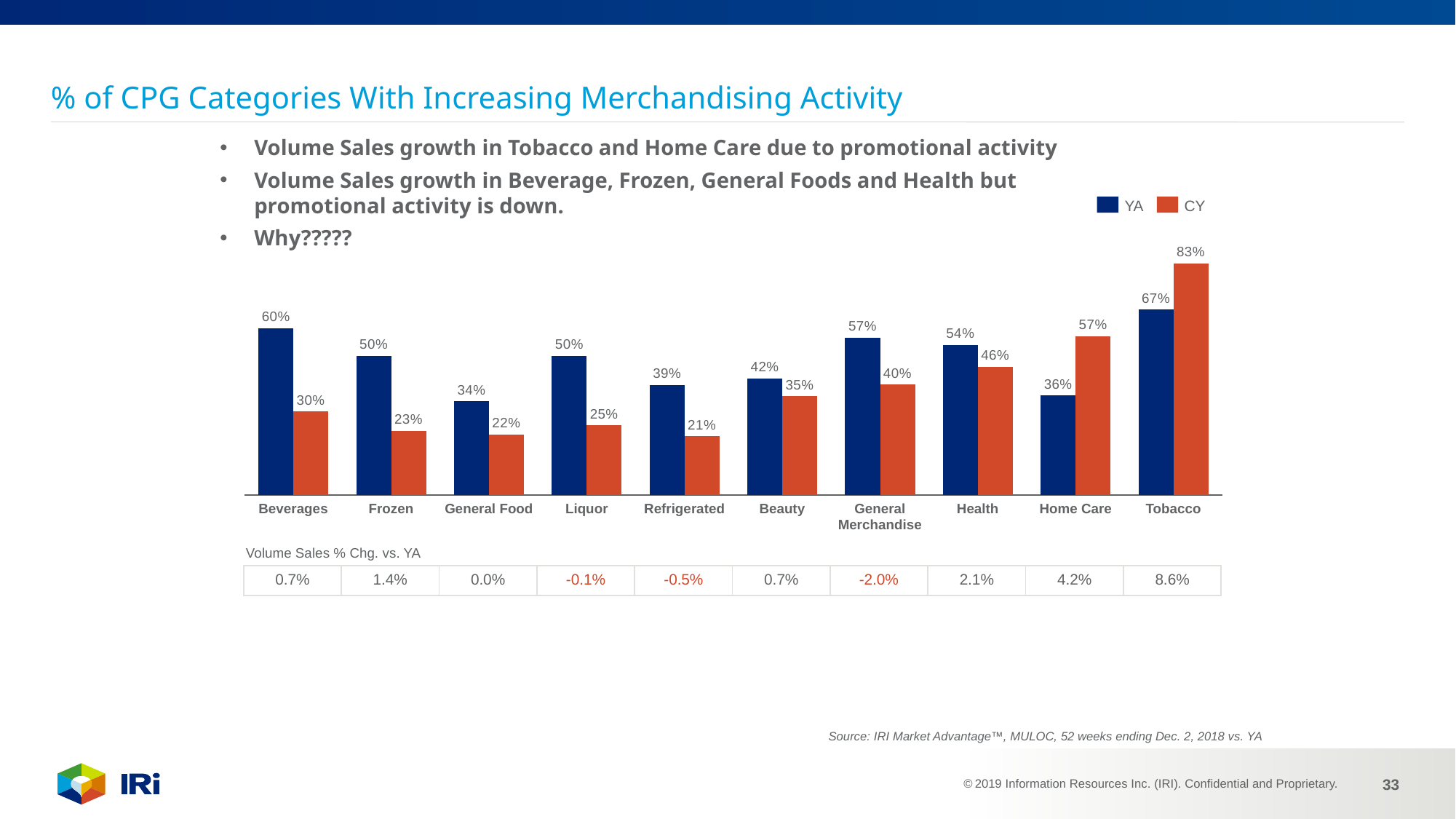
Which category has the lowest YA value? General Food What kind of chart is shown on the slide? Bar chart Which category has the highest CY value? Tobacco What is the CY value for Tobacco? 83% What is the difference between the YA and CY values for Beverages? 30% Which category has the lowest CY value? Refrigerated What is the CY value for Home Care? 57% How many categories are shown on the x axis? 10 What is the YA value for Beverages? 60% How many series does the legend list? 2 Which is larger for Home Care, the YA value or the CY value? CY What is the difference between the CY and YA values for Tobacco? 16%